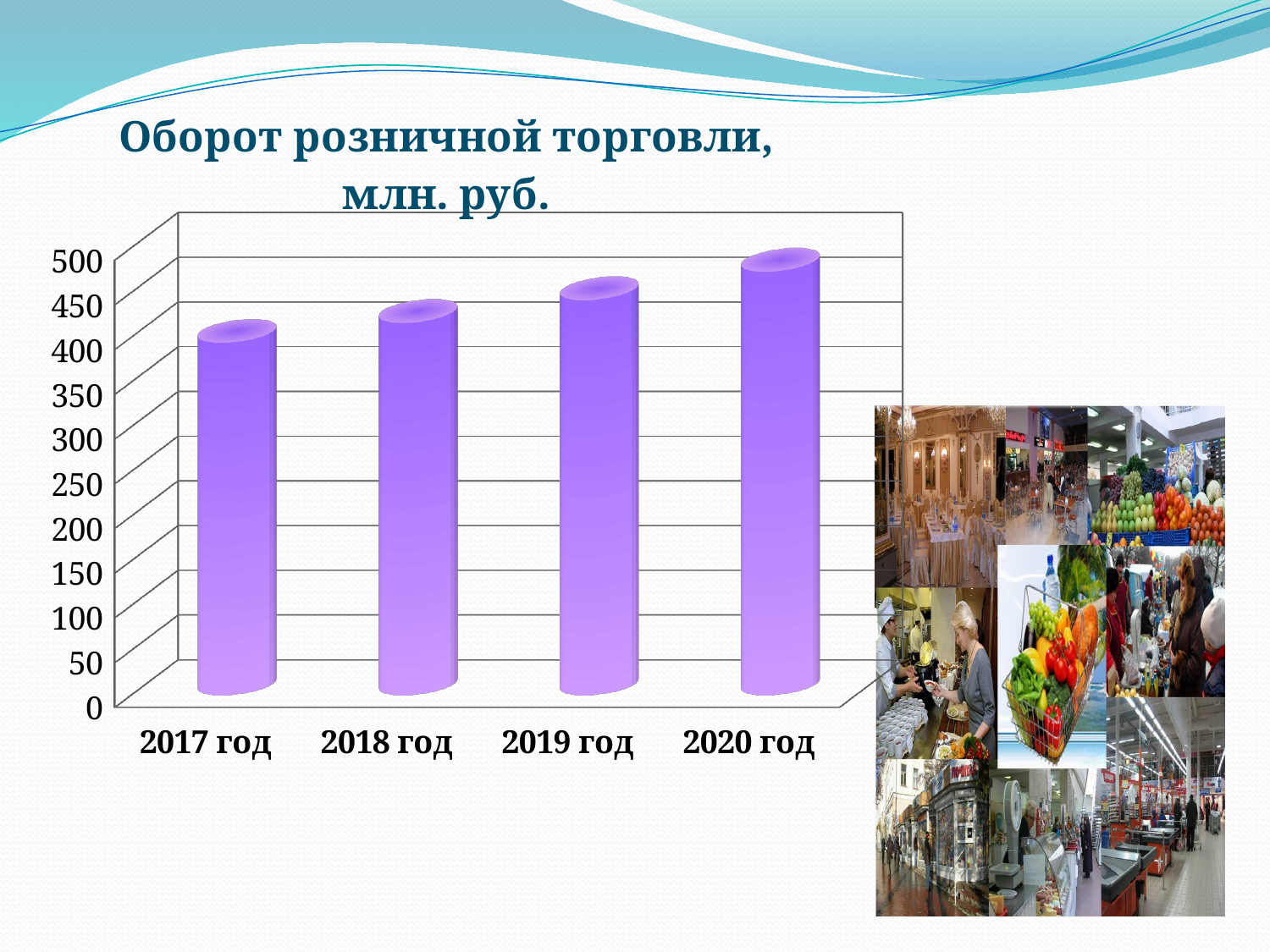
What is the highest value shown on the vertical axis of the chart? 500 Which is larger, the value for 2017 год or the value for 2020 год? 2020 год Do the values in the chart rise or fall from 2017 to 2020? rise How many years (categories) are shown on the x axis of the chart? 4 What is the title of the chart? Оборот розничной торговли, млн. руб. Which year has the highest retail trade turnover in the chart? 2020 год Which year has the lowest retail trade turnover in the chart? 2017 год Is the value for 2020 год greater or less than 400? greater Is the value for 2017 год greater or less than 300? greater Which is larger, the value for 2018 год or the value for 2019 год? 2019 год Is the value for 2018 год greater or less than 500? less What kind of chart is shown on the slide? bar chart